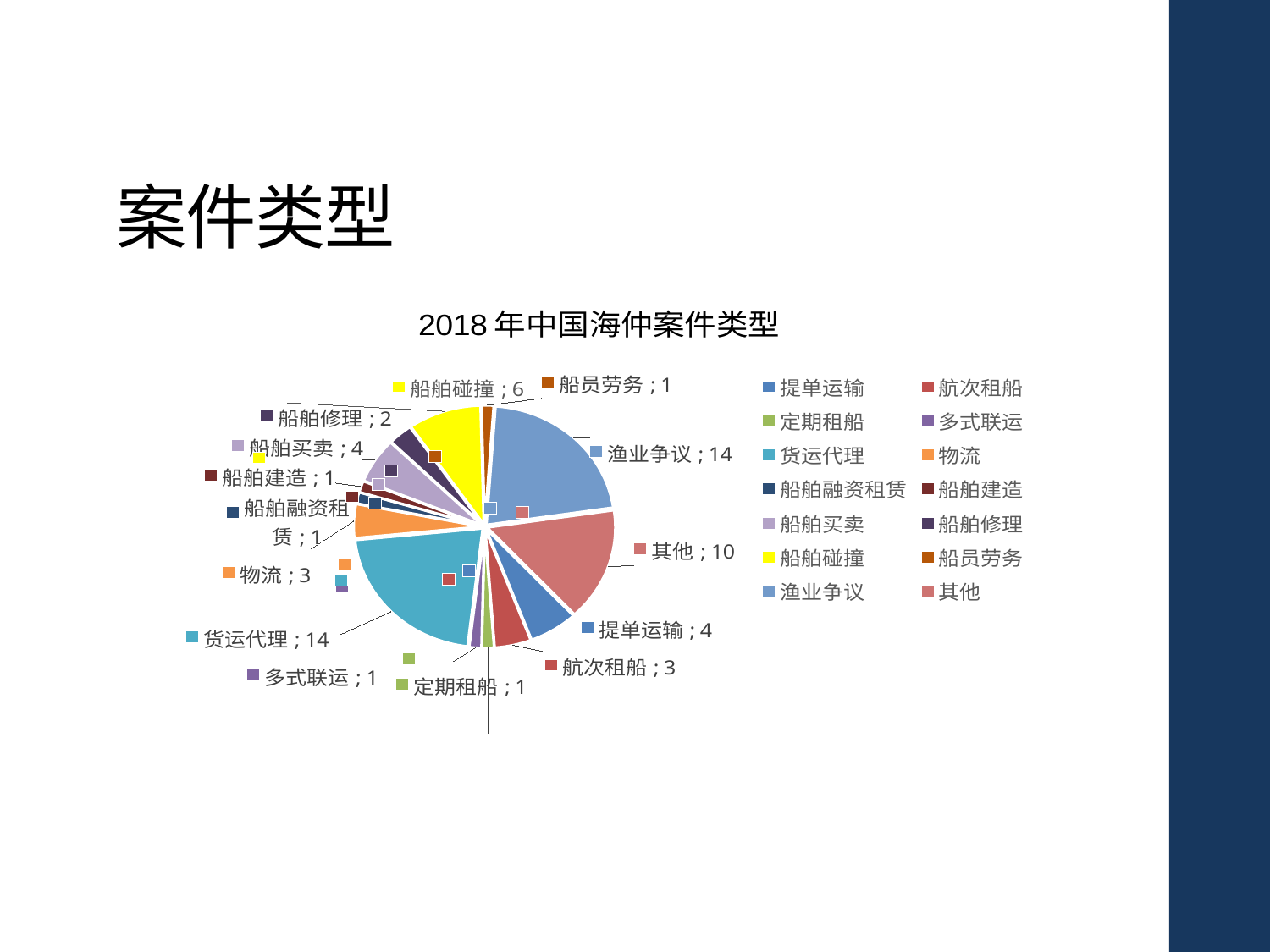
What is the value for 渔业争议? 14 What is the value for 船舶碰撞? 6 What is the value for 货运代理? 14 How many categories does the pie chart have? 14 What is the difference between the values for 其他 and 船舶碰撞? 4 What is the value for 其他? 10 Which is larger, 提单运输 or 航次租船? 提单运输 What is the value for 船舶修理? 2 How many entries does the legend list? 14 What type of chart is shown on the slide? pie chart What is the value for 物流? 3 What is the title of the chart? 2018 年中国海仲案件类型